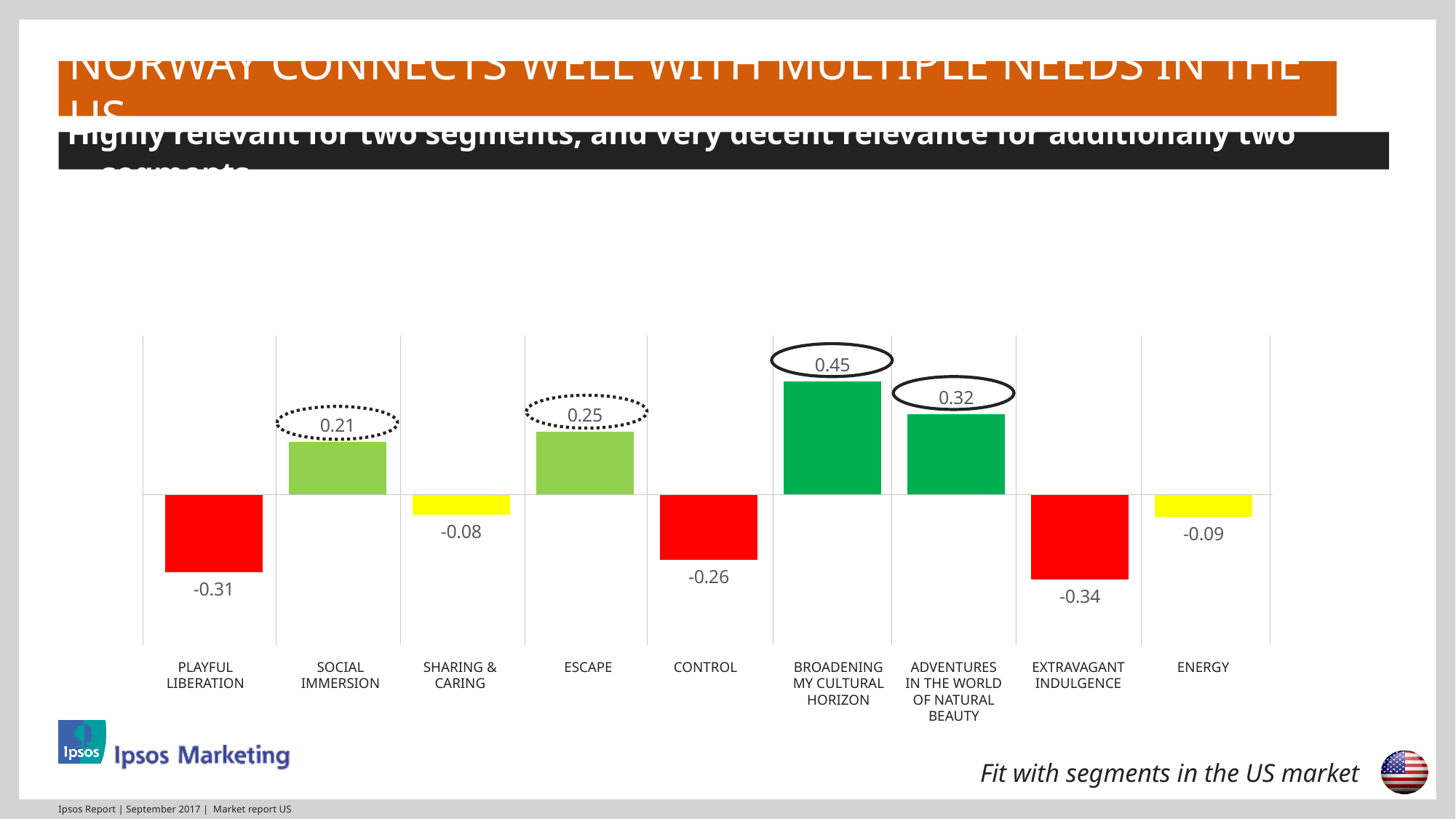
Which category has the highest value? Broadening My Cultural Horizon How many categories have a negative value? 5 What is the value for Energy? -0.09 What is the value for Broadening My Cultural Horizon? 0.45 What kind of chart is shown on the slide? Bar chart Which is larger, the value for Social Immersion or the value for Escape? Escape What colour are the bars for Sharing & Caring and Energy? Yellow How many categories are shown in the chart? 9 What is the difference between the values for Broadening My Cultural Horizon and Adventures in the World of Natural Beauty? 0.13 What is the value for Escape? 0.25 What is the value for Extravagant Indulgence? -0.34 Which category has the lowest value? Extravagant Indulgence